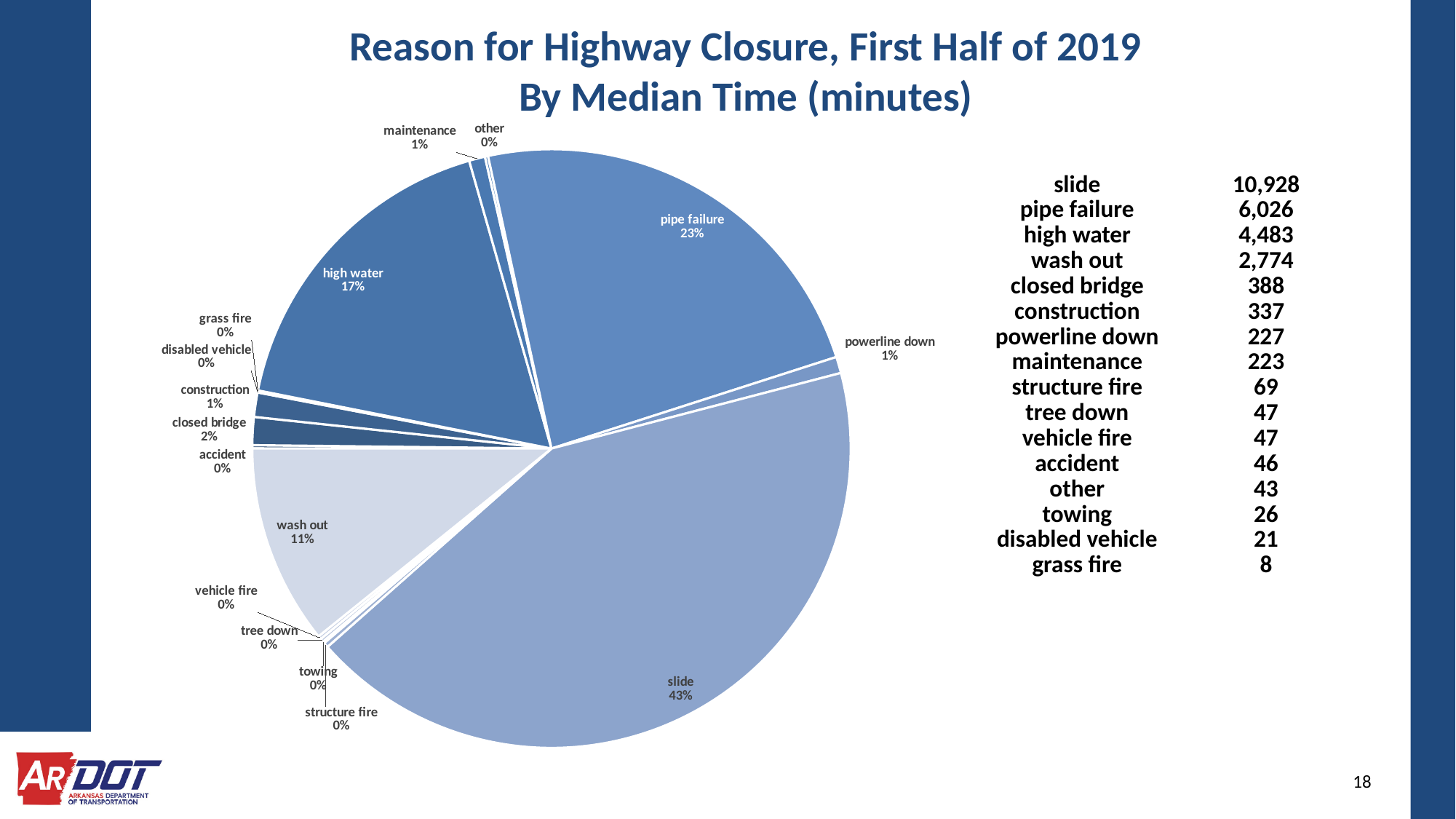
What is the median time value listed for powerline down? 227 Which is larger, the value for pipe failure or the value for high water? pipe failure What kind of chart is shown on the slide? pie chart How many categories are shown in the pie chart? 16 Which category has the smallest value in the table next to the pie chart? grass fire What is the median time value listed for closed bridge? 388 What share of the pie does the slide slice represent? 43% What share of the pie does the pipe failure slice represent? 23% What is the difference between the values for slide and pipe failure? 4,902 Which category has the largest slice of the pie? slide What share of the pie does the wash out slice represent? 11%